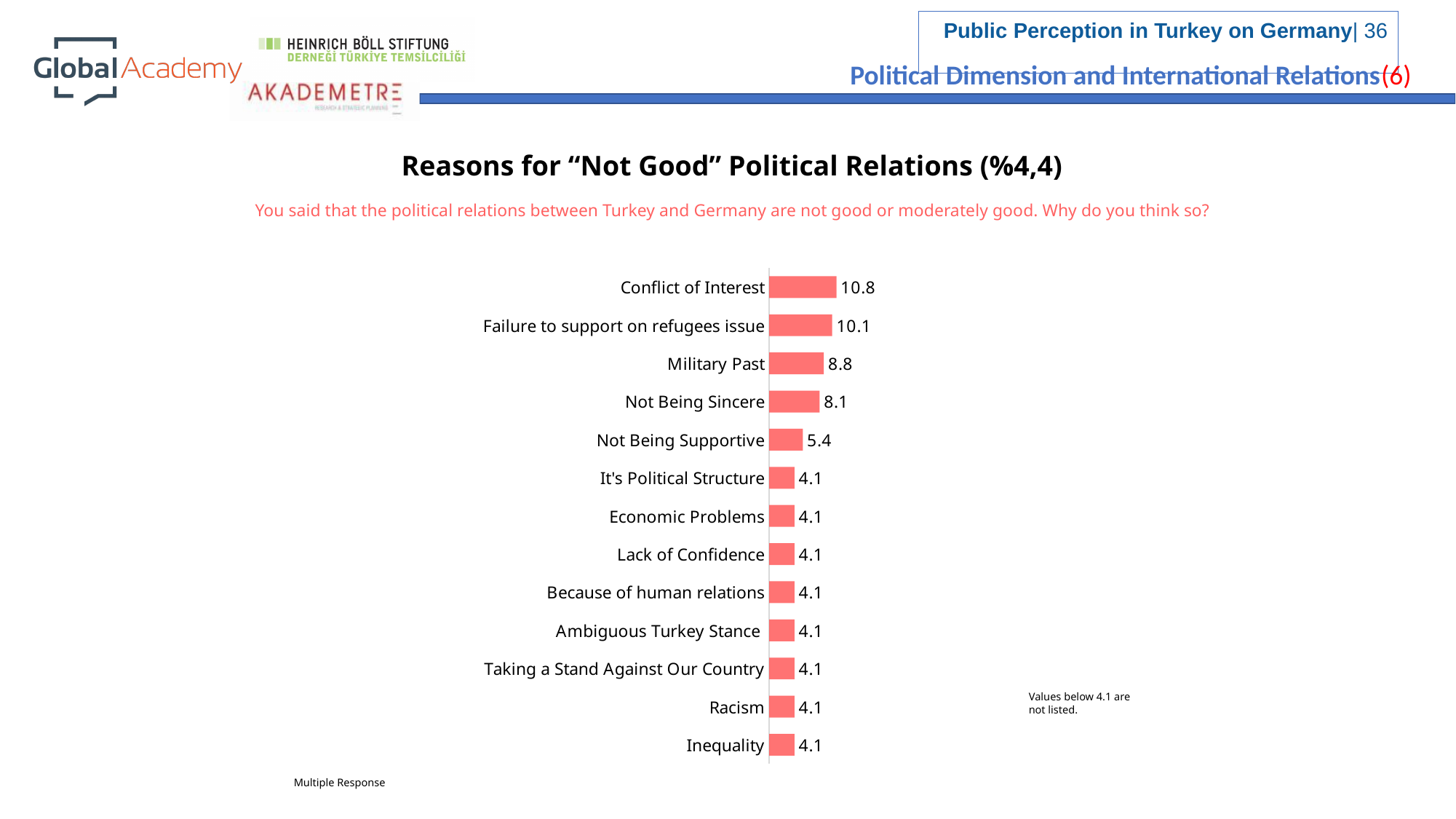
Which reason has the highest value? Conflict of Interest What is the value for Not Being Supportive? 5.4 How many reasons have a value of 4.1? 8 What kind of chart is shown on the slide? Bar chart Which is larger, the value for Military Past or the value for Not Being Sincere? Military Past How many reasons are listed in the chart? 13 What is the value for Military Past? 8.8 What is the value for Conflict of Interest? 10.8 What is the title of the chart? Reasons for “Not Good” Political Relations (%4,4) What is the difference between the values for Not Being Sincere and Not Being Supportive? 2.7 What is the difference between the values for Conflict of Interest and Military Past? 2.0 What is the value for Failure to support on refugees issue? 10.1